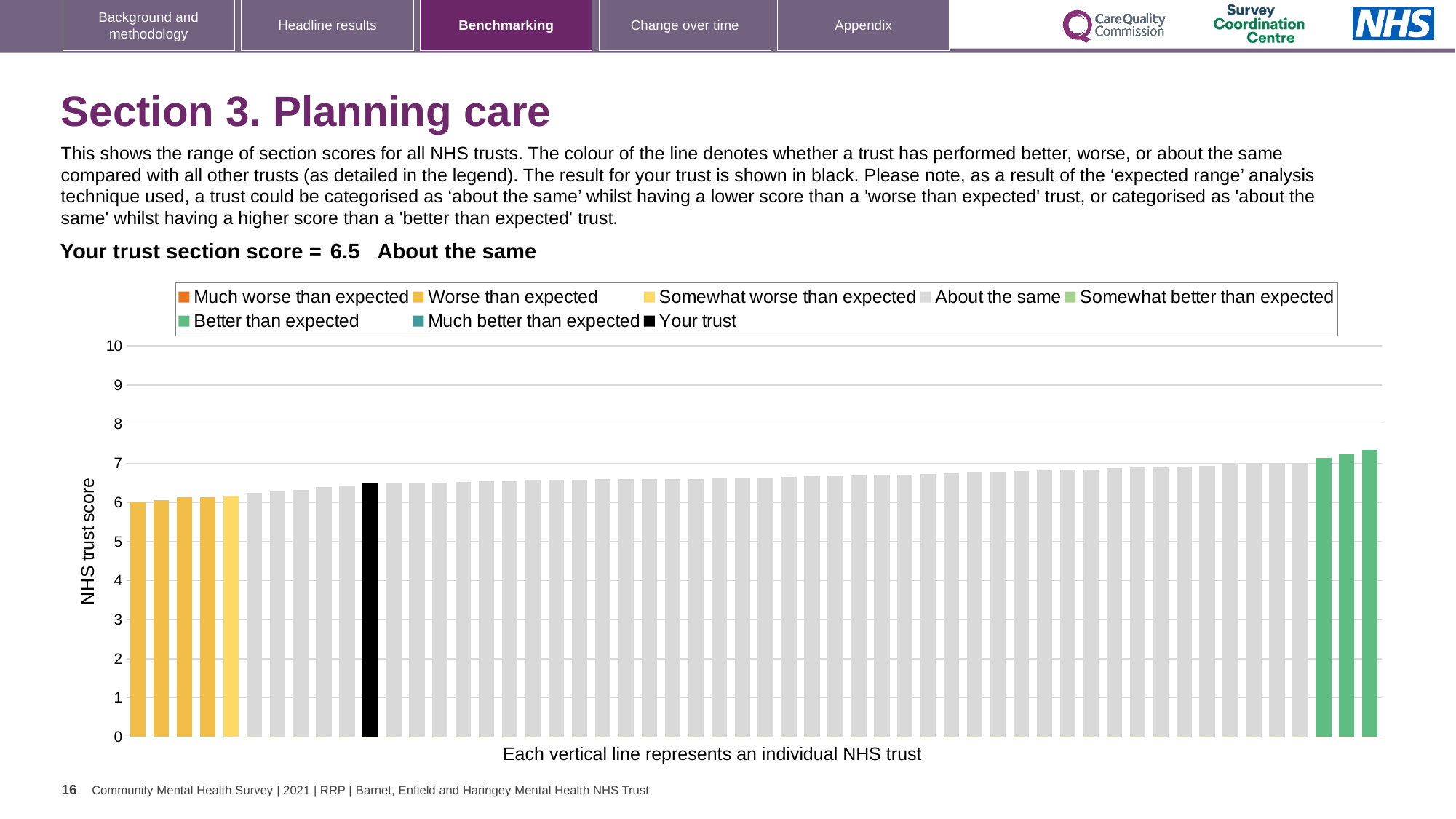
Is the value for your trust (the black bar) greater or less than 5? greater Is the value of the tallest bar in the chart greater or less than 7? greater What is the title of the vertical axis? NHS trust score How many entries does the chart legend list? 8 Which is taller: the black bar for your trust or the leftmost bar? the black bar for your trust What colour is used for the bar representing your trust? black Do the bar values rise or fall moving from left to right along the x axis? rise Which category is your trust placed in for this section? About the same What kind of chart is shown on the slide? bar chart How many bars are coloured green (better than expected)? 3 What is the section score for your trust shown on the slide? 6.5 Is the value of the leftmost bar in the chart greater or less than 7? less